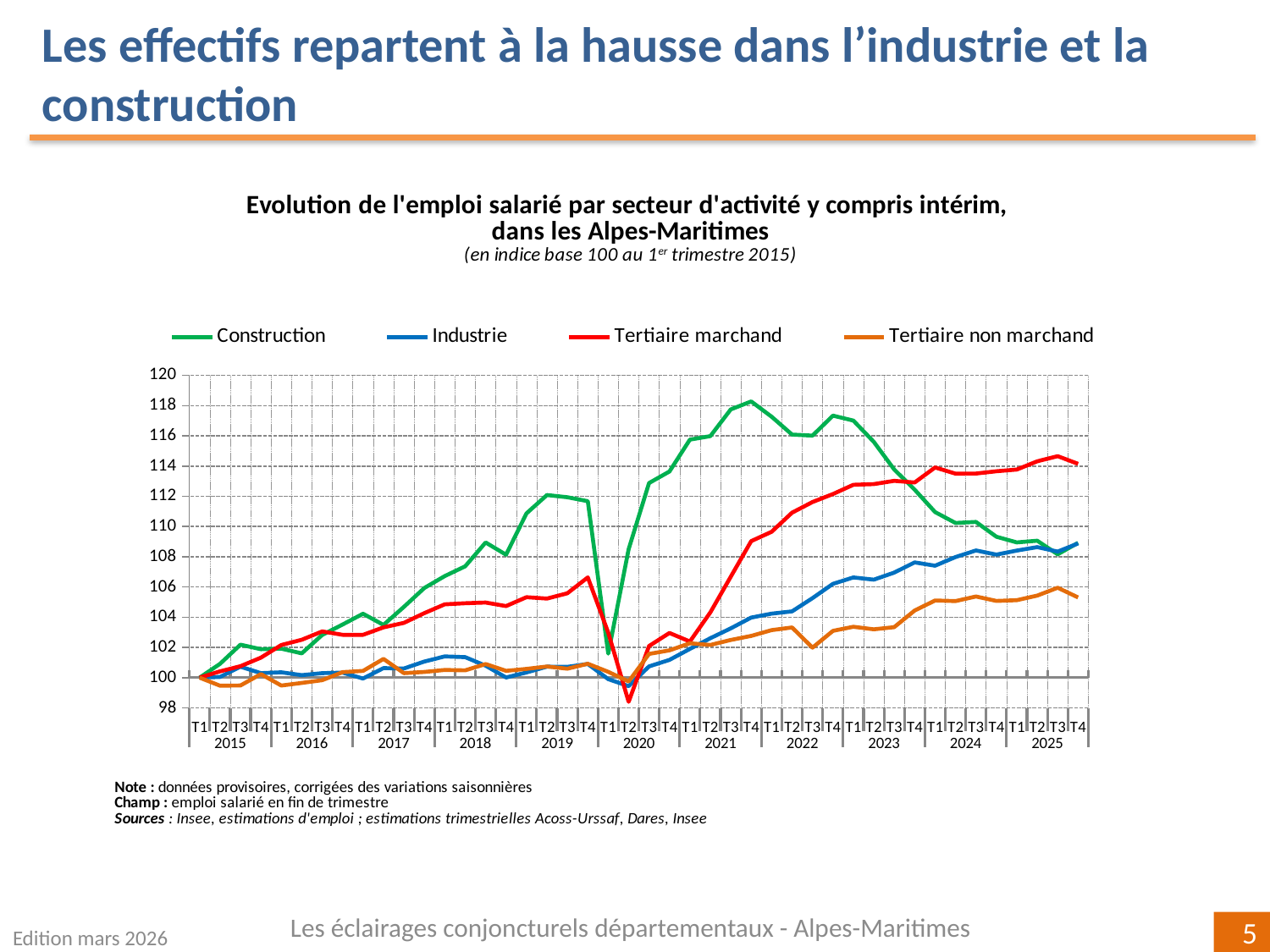
Which series are listed in the legend? Construction, Industrie, Tertiaire marchand, Tertiaire non marchand What is the index value of all series at T1 2015, the base period? 100 Is the value for Tertiaire marchand at T2 2020 greater or less than 100? less Which series falls to the lowest value on the chart, at T2 2020? Tertiaire marchand Is the value for Tertiaire non marchand at T4 2025 greater or less than 104? greater Which series reaches the highest value anywhere on the chart? Construction How many years are shown along the x axis? 11 How many series does the legend list? 4 Does the Construction series rise or fall between T4 2021 and T4 2025? fall Is the value for Construction at T4 2021 greater or less than 116? greater What kind of chart is shown on the slide? line chart At T4 2025, which is larger: Tertiaire marchand or Construction? Tertiaire marchand